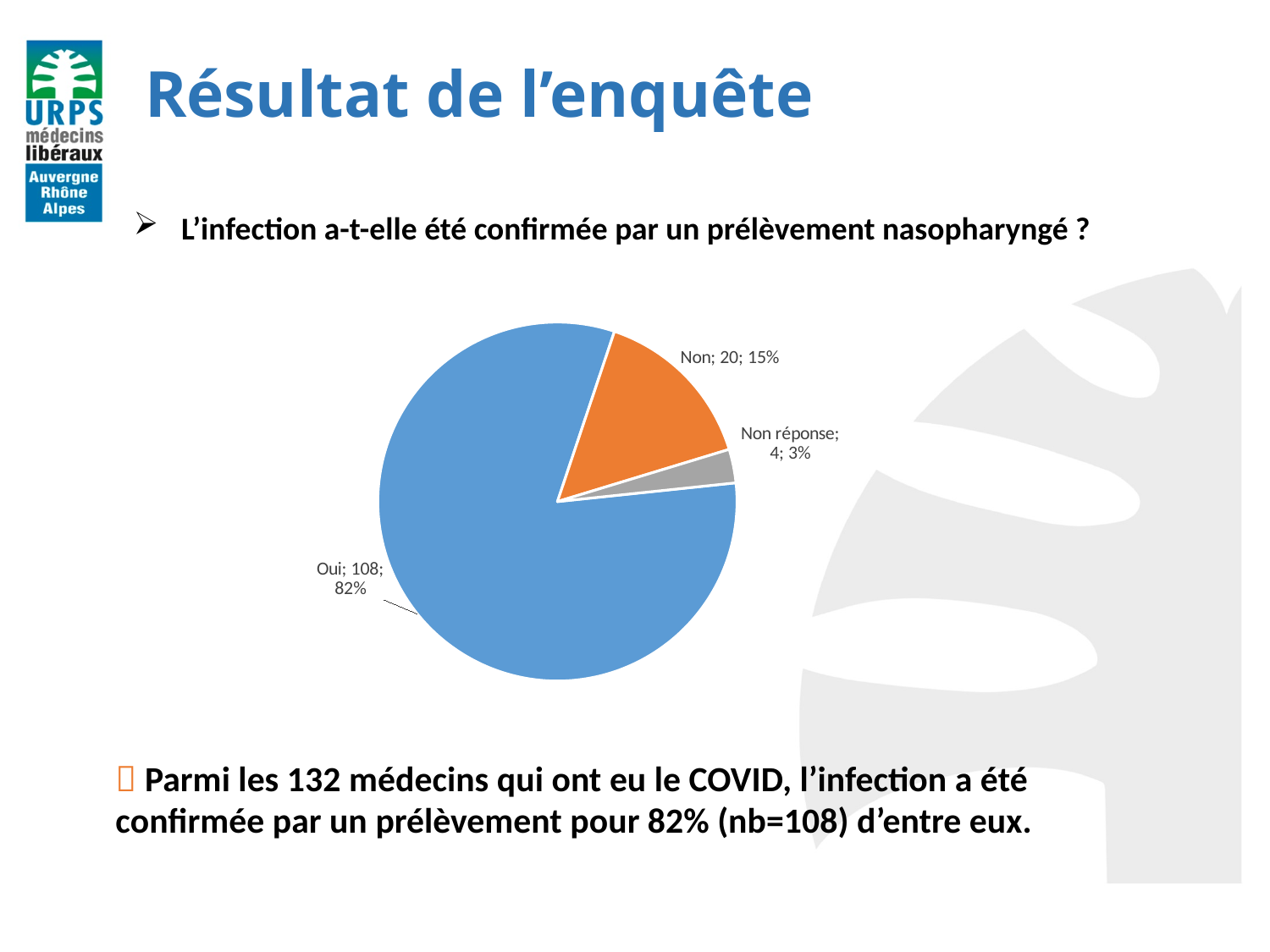
What is the count for the "Non réponse" slice? 4 What kind of chart is shown on the slide? pie chart What is the count for the "Oui" slice? 108 Which slice is the largest? Oui How many slices does the pie chart have? 3 What is the total count across all slices of the pie chart? 132 What is the difference in count between the "Oui" and "Non" slices? 88 What percentage share does the "Non" slice represent? 15% What percentage share does the "Oui" slice represent? 82% What colour is the "Non" slice? orange Which slice is the smallest? Non réponse Which slice has a larger count, "Non" or "Non réponse"? Non